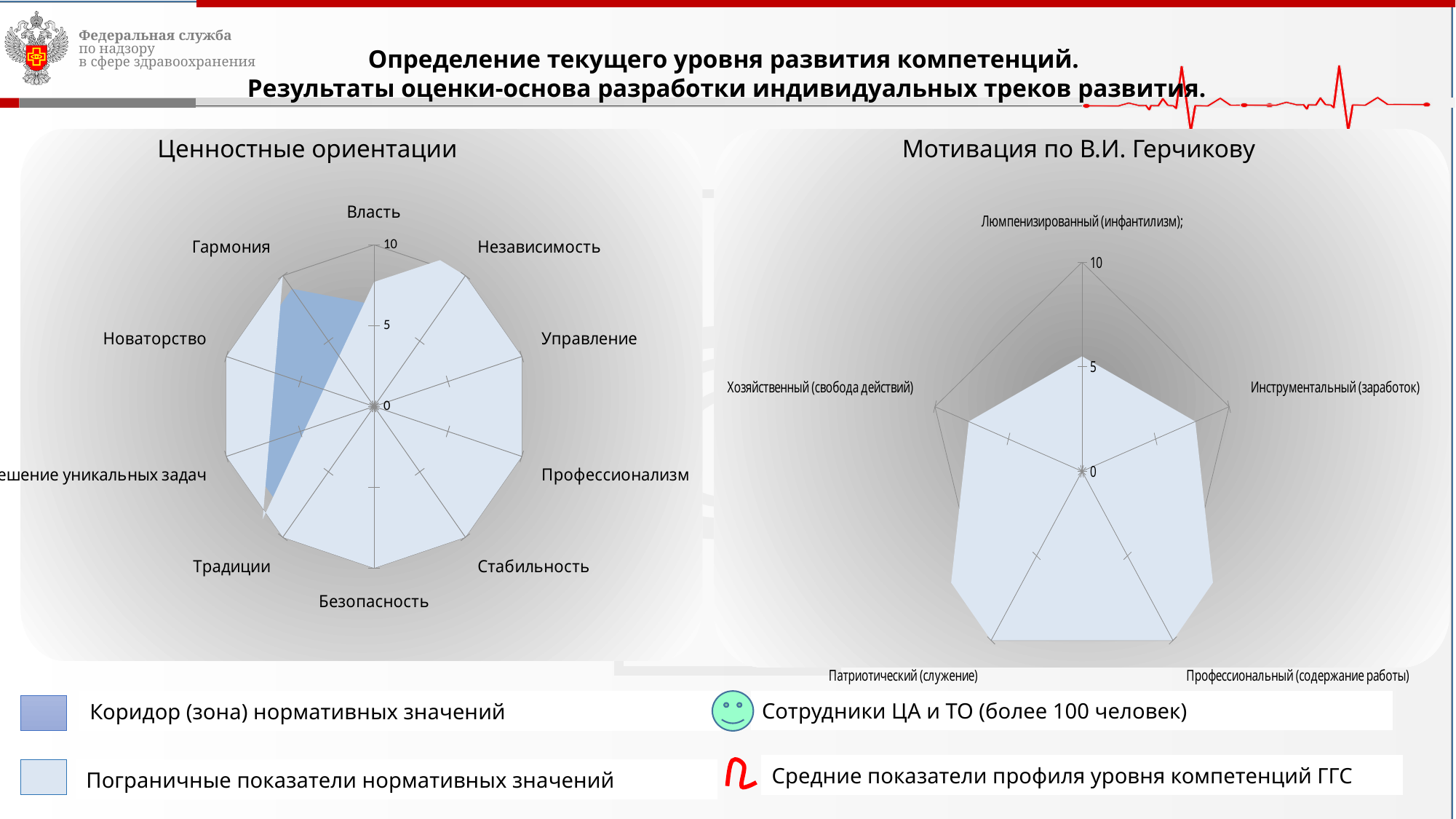
What is the title of the radar chart on the right side of the slide? Мотивация по В.И. Герчикову In the "Ценностные ориентации" chart, which category is located directly opposite Власть on the radar? Безопасность In the "Ценностные ориентации" chart, is the value for Безопасность greater or less than 5? greater How many categories (axes) does the "Ценностные ориентации" chart have? 10 In the "Мотивация по В.И. Герчикову" chart, is the value for Инструментальный (заработок) greater or less than 5? greater What kind of chart is the "Мотивация по В.И. Герчикову" chart on the right? Radar chart How many categories (axes) does the "Мотивация по В.И. Герчикову" chart have? 5 In the "Мотивация по В.И. Герчикову" chart, is the value for Профессиональный (содержание работы) greater or less than 5? greater What is the maximum value shown on the axis scale of the "Ценностные ориентации" chart? 10 What kind of chart is the "Ценностные ориентации" chart on the left? Radar chart